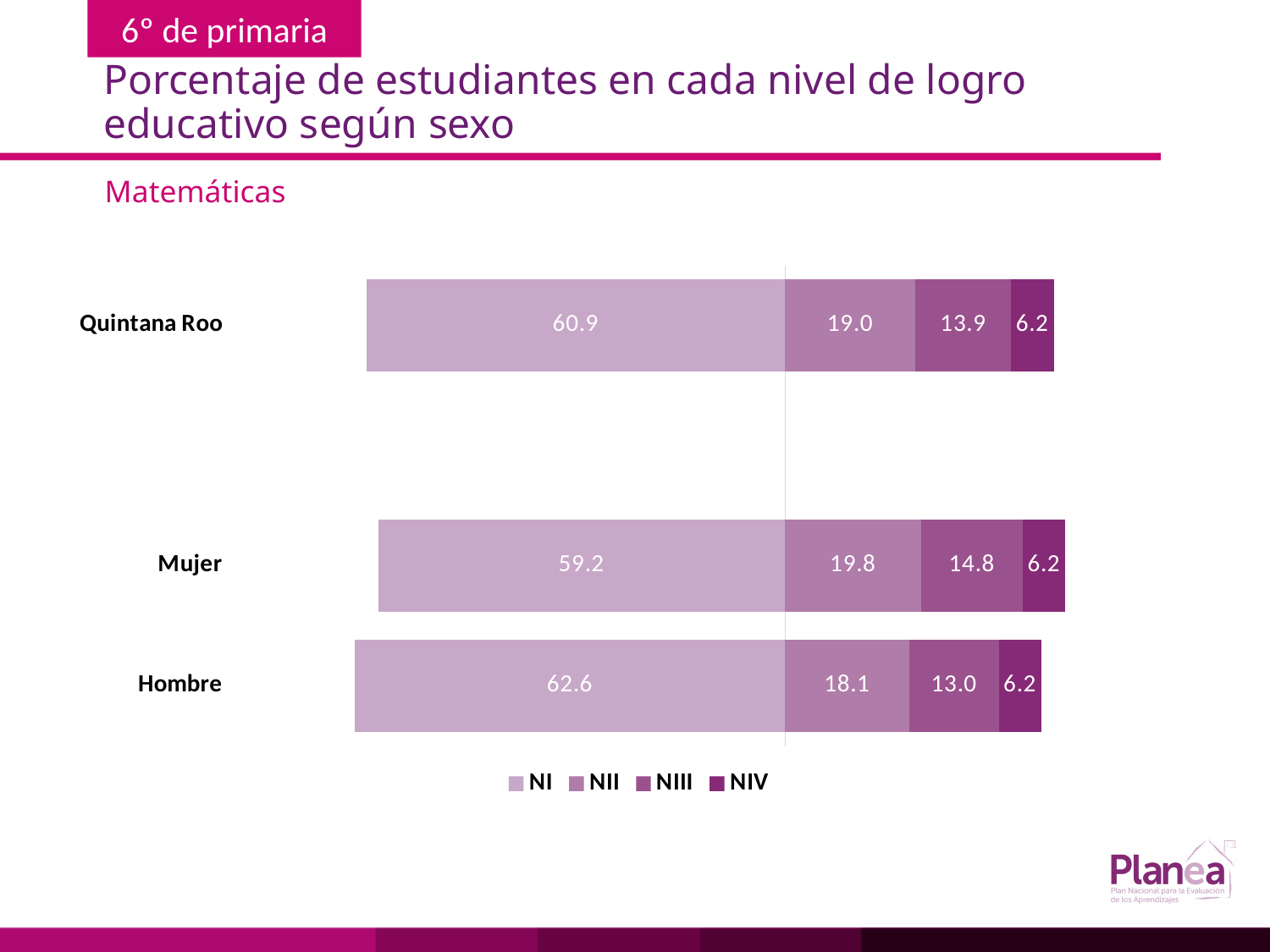
How many categories are shown in the chart? 3 What is the difference between the NI values for Hombre and Mujer? 3.4 How many series does the legend list? 4 What is the total of the stacked bar for Quintana Roo? 100.0 What is the NI value for Hombre? 62.6 Which category has the lowest NIII value? Hombre What is the NIV value for Hombre? 6.2 What is the NIII value for Quintana Roo? 13.9 What is the NII value for Mujer? 19.8 What kind of chart is shown on the slide? Stacked bar chart Which category has the highest NI value? Hombre Which is larger, the NII value for Mujer or the NII value for Hombre? Mujer